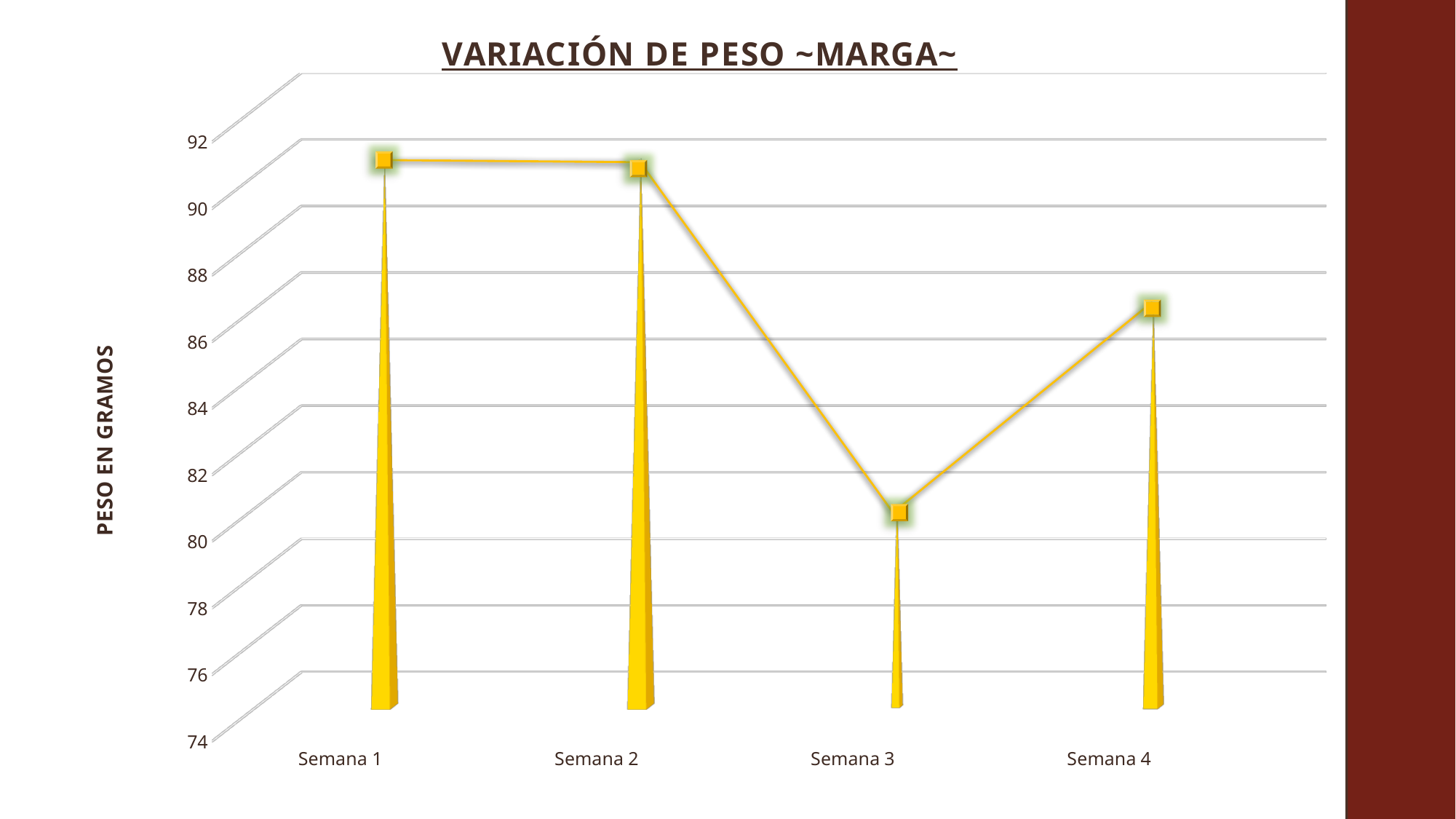
What is the label on the vertical axis of the chart? PESO EN GRAMOS Is the value for Semana 1 greater or less than 90? greater Does the weight rise or fall from Semana 2 to Semana 3? fall Which is larger, the value for Semana 3 or the value for Semana 4? Semana 4 Is the value for Semana 3 greater or less than 82? less Is the value for Semana 4 greater or less than 88? less How many weeks (categories) are plotted on the x axis? 4 Does the weight rise or fall from Semana 3 to Semana 4? rise Which week has the lowest weight value? Semana 3 What kind of chart is shown on the slide? bar chart What is the title of the chart? VARIACIÓN DE PESO ~MARGA~